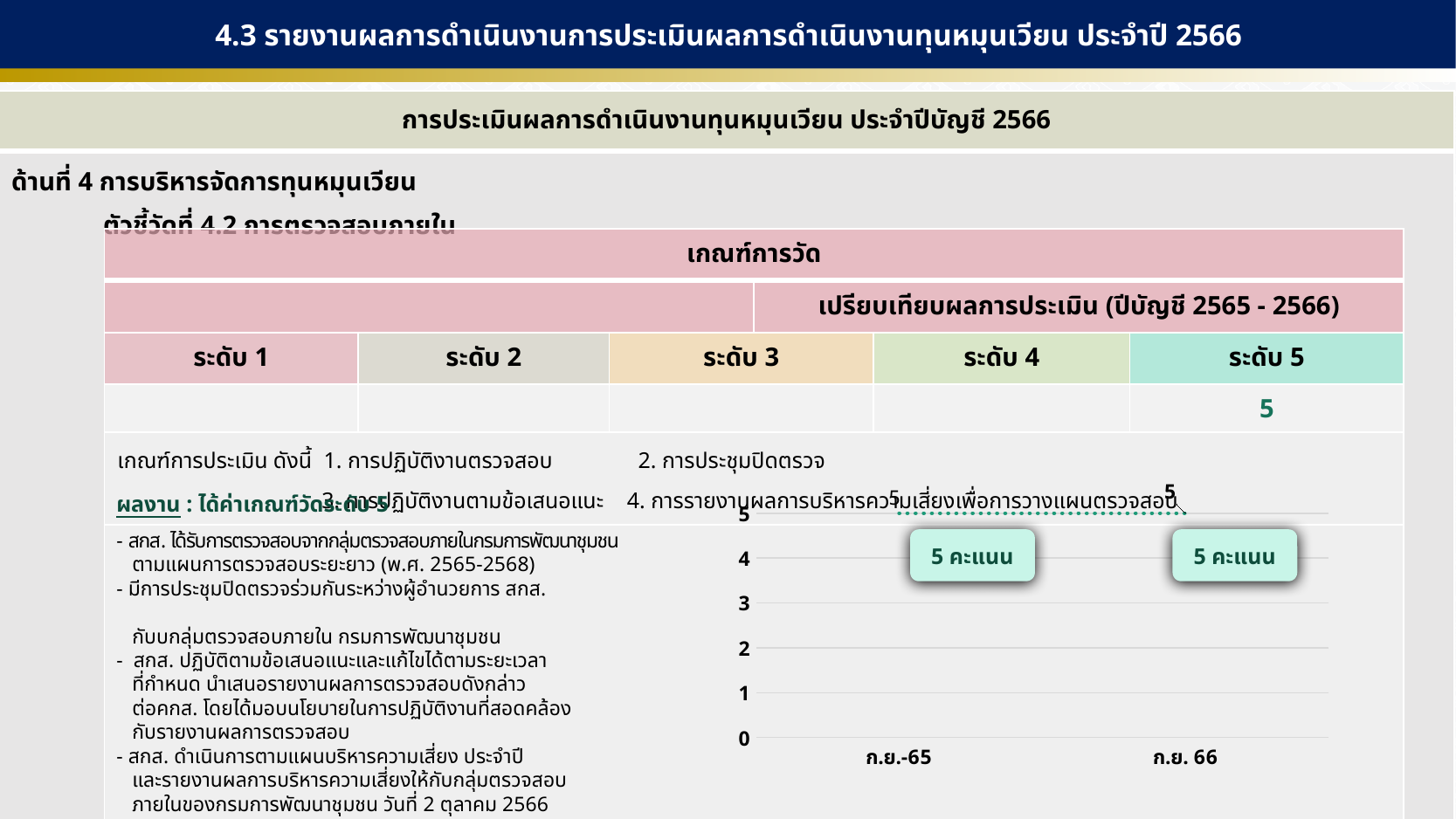
What is the value plotted for ก.ย.-65 in the chart? 5 Is the value for ก.ย. 66 greater or less than 3? greater Is the value for ก.ย. 66 greater than, less than, or equal to the value for ก.ย.-65? equal Do the values rise, fall, or stay the same from ก.ย.-65 to ก.ย. 66? stay the same What is the difference between the values for ก.ย.-65 and ก.ย. 66 in the chart? 0 What is the value plotted for ก.ย. 66 in the chart? 5 How many data points are plotted in the chart? 2 What text is shown in the callout boxes above the data points in the chart? 5 คะแนน What is the highest tick value shown on the chart's y axis? 5 What kind of chart is shown on the slide? line chart Is the value for ก.ย.-65 greater or less than 4? greater